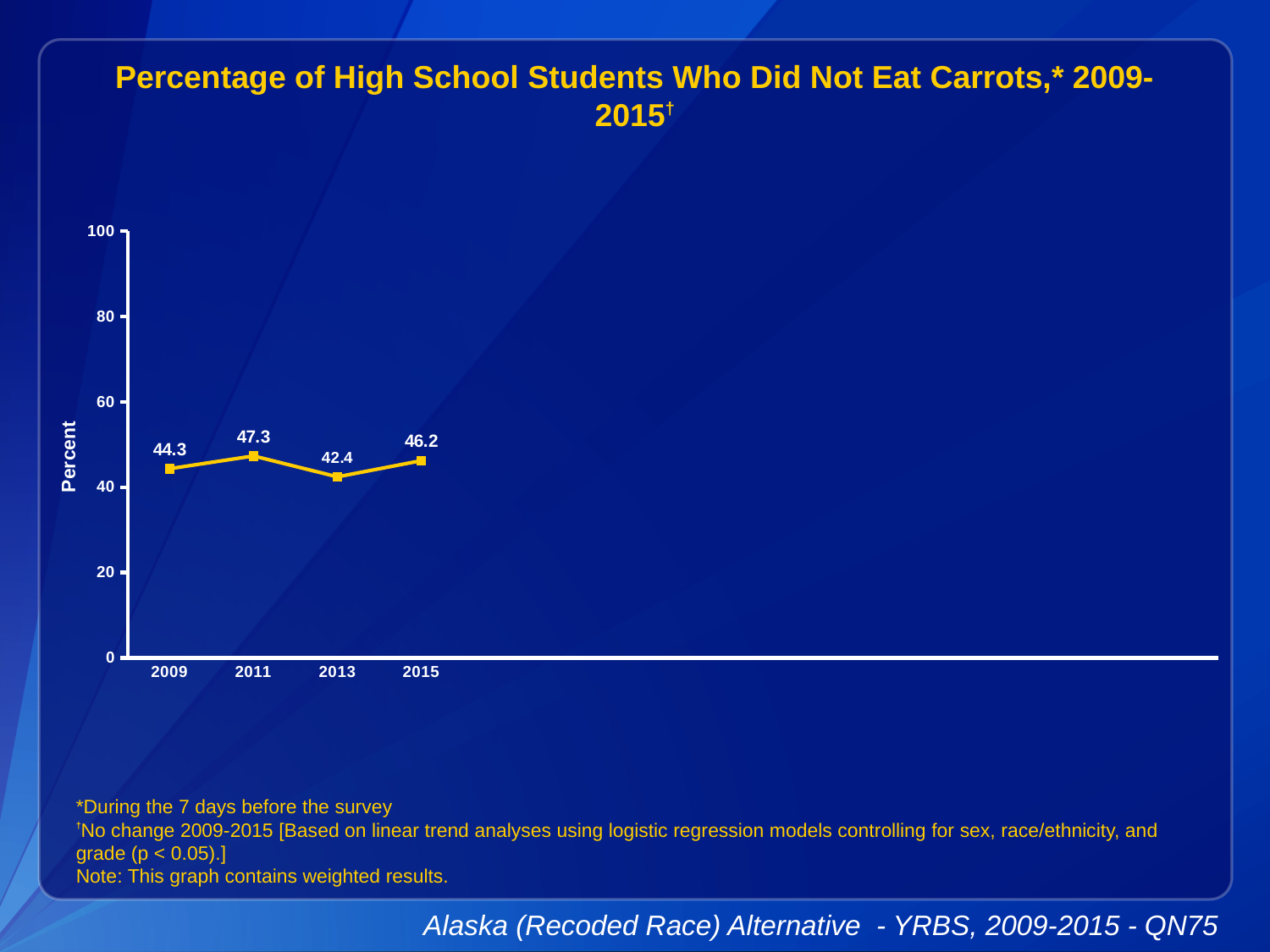
Which year has a larger value, 2009 or 2015? 2015 What kind of chart is shown on the slide? line chart Which year has the highest percentage of students who did not eat carrots? 2011 Is the value for 2011 greater or less than 60? less What is the value plotted for 2013? 42.4 How many years are plotted on the chart? 4 What is the label on the vertical axis of the chart? Percent What percentage of high school students did not eat carrots in 2009? 44.3 Does the value rise or fall from 2013 to 2015? rise Which year has the lowest percentage of students who did not eat carrots? 2013 What is the value plotted for 2015? 46.2 What is the difference between the 2011 value and the 2013 value? 4.9